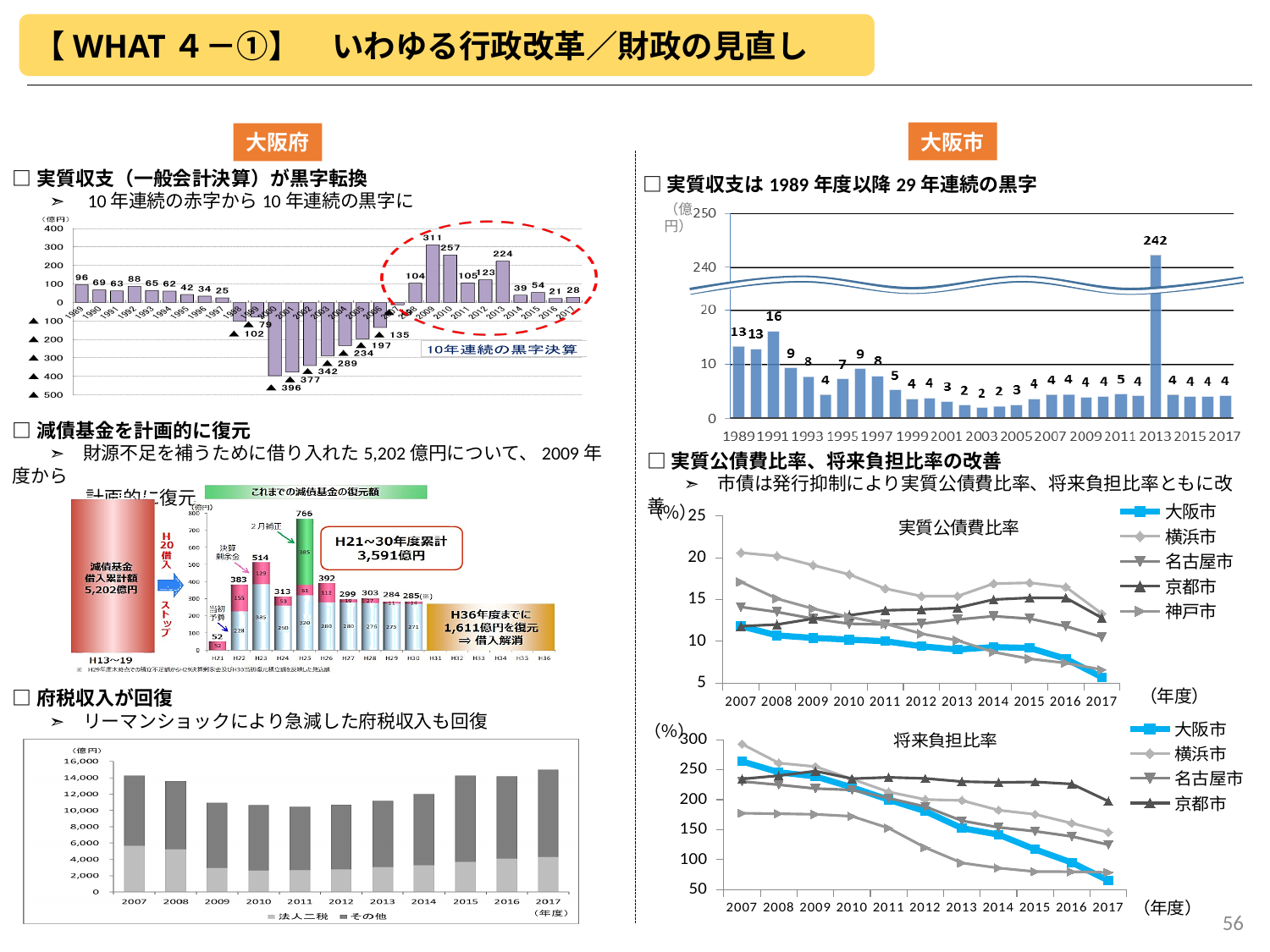
What kind of chart is the 大阪市 実質収支 chart at the top right? bar chart In the 府税収入 stacked bar chart (bottom left), how many years are shown on the x axis? 11 In the 大阪府 実質収支 bar chart (top left), what is the highest value shown? 311 How many series does the legend of the 実質公債費比率 chart list? 5 In the 実質公債費比率 chart, is the value for 大阪市 in 2017 greater or less than 10? less In the 大阪市 実質収支 bar chart (top right), which year has the highest value? 2013 In the 将来負担比率 chart, is the value for 横浜市 in 2007 greater or less than 250? greater How many series does the legend of the 将来負担比率 chart list? 4 In the 実質公債費比率 chart, does the 大阪市 line rise or fall from 2007 to 2017? fall In the 大阪市 実質収支 bar chart (top right), what is the value for 2013? 242 In the 実質公債費比率 chart, which is higher in 2007, 横浜市 or 大阪市? 横浜市 In the 大阪市 実質収支 bar chart (top right), what is the value for 1991? 16